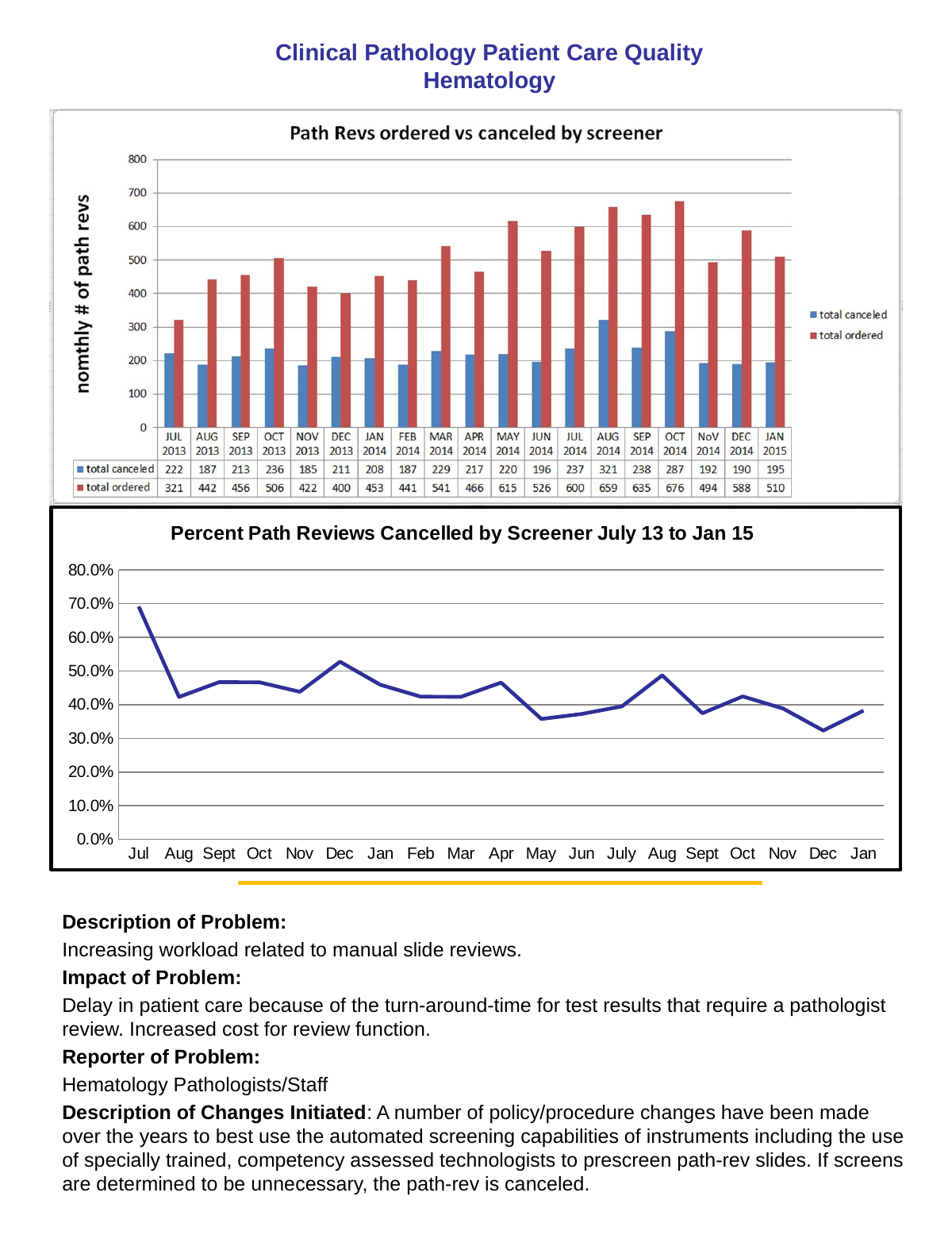
In the 'Path Revs ordered vs canceled by screener' chart, which month has the lowest total canceled? NOV 2013 In the 'Percent Path Reviews Cancelled by Screener July 13 to Jan 15' chart, is the value for the first Jul greater or less than 60.0%? greater In the 'Path Revs ordered vs canceled by screener' chart, which is larger: total ordered in MAY 2014 or total ordered in JUN 2014? MAY 2014 In the 'Path Revs ordered vs canceled by screener' chart, which month has the highest total ordered? OCT 2014 How many months are shown in the 'Path Revs ordered vs canceled by screener' chart? 19 In the 'Path Revs ordered vs canceled by screener' chart, what is the total canceled value for AUG 2014? 321 How many series does the legend of the 'Path Revs ordered vs canceled by screener' chart list? 2 What kind of chart is 'Path Revs ordered vs canceled by screener'? Bar chart In the 'Path Revs ordered vs canceled by screener' chart, what is the total ordered value for OCT 2014? 676 In the 'Percent Path Reviews Cancelled by Screener July 13 to Jan 15' chart, is the value for Dec (the second Dec, near the right end) greater or less than 40.0%? less In the 'Path Revs ordered vs canceled by screener' chart, what is the difference between total ordered and total canceled in OCT 2014? 389 What kind of chart is 'Percent Path Reviews Cancelled by Screener July 13 to Jan 15'? Line chart